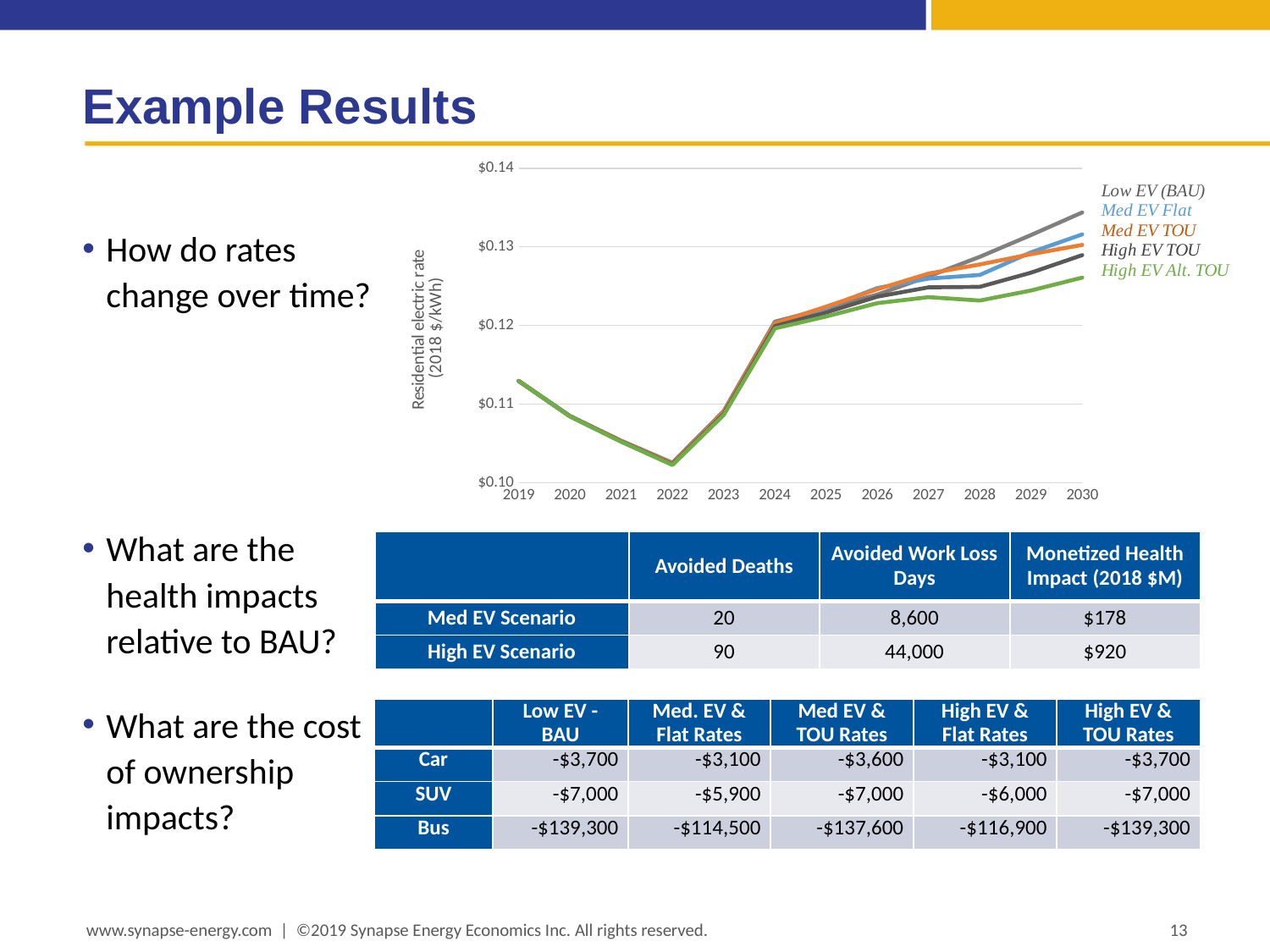
Is the residential electric rate in 2019 greater or less than $0.11? greater Do the rates rise or fall between 2022 and 2030? rise How many years are shown along the x axis of the chart? 12 In which year do the lines reach their lowest value? 2022 Is the Low EV (BAU) rate in 2030 greater or less than $0.13? greater Which series has the highest residential electric rate in 2030? Low EV (BAU) Which series has the lowest residential electric rate in 2030? High EV Alt. TOU In 2030, which is larger: the Med EV Flat rate or the High EV Alt. TOU rate? Med EV Flat How many series does the chart's legend list? 5 Is the High EV Alt. TOU rate in 2030 greater or less than $0.13? less What kind of chart is shown on the slide? line chart